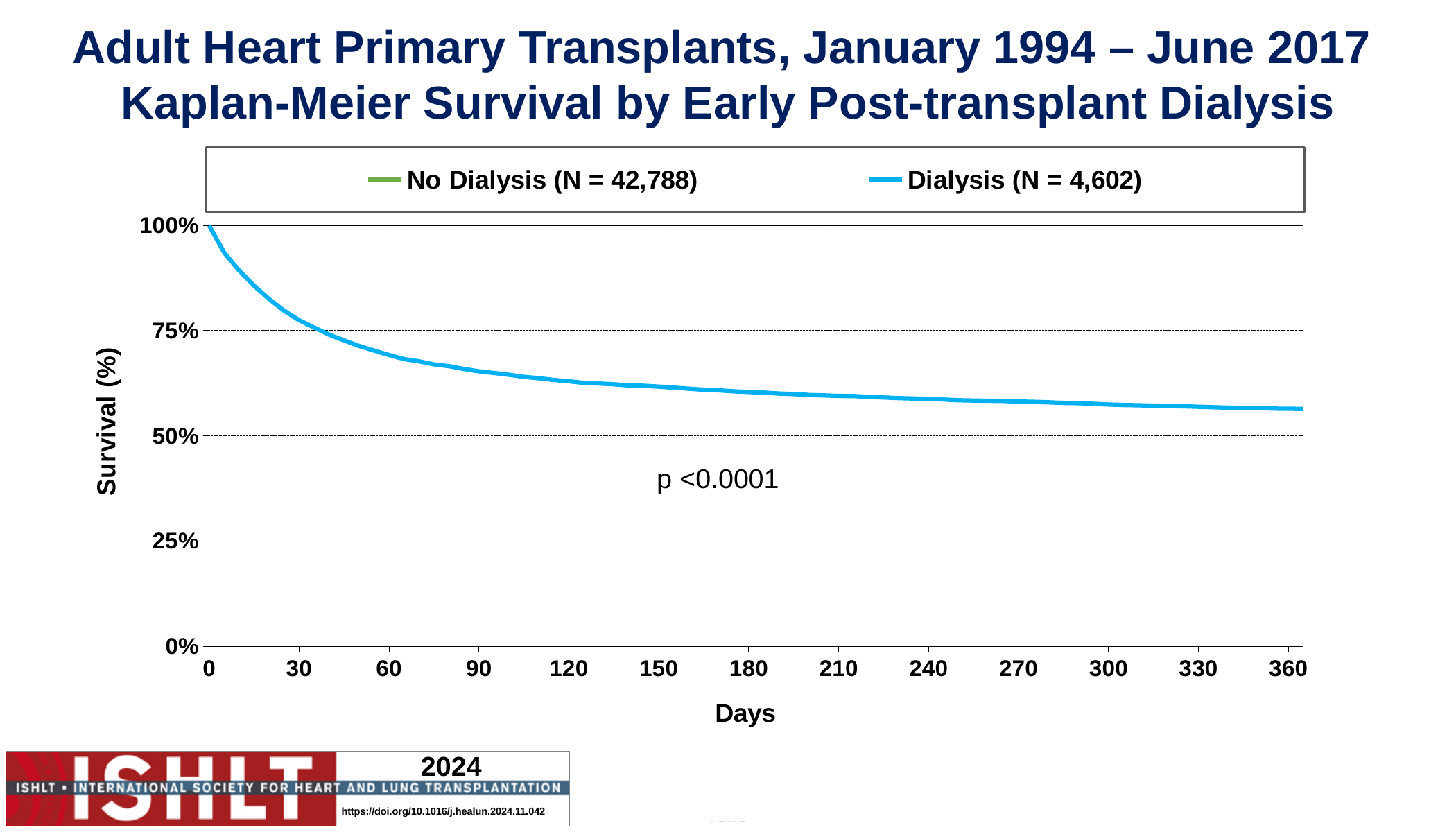
Is the Dialysis survival value at 360 days greater or less than 50%? greater What kind of chart is shown on the slide? line chart What is the N for the Dialysis group shown in the legend? 4,602 Is the Dialysis survival value at 180 days greater or less than 75%? less Does the Dialysis survival curve rise or fall as days increase? fall What p-value is printed on the chart? p <0.0001 What is the survival value for the Dialysis group at day 0? 100% How many series does the legend list? 2 Is the Dialysis survival value at 60 days greater or less than 75%? less